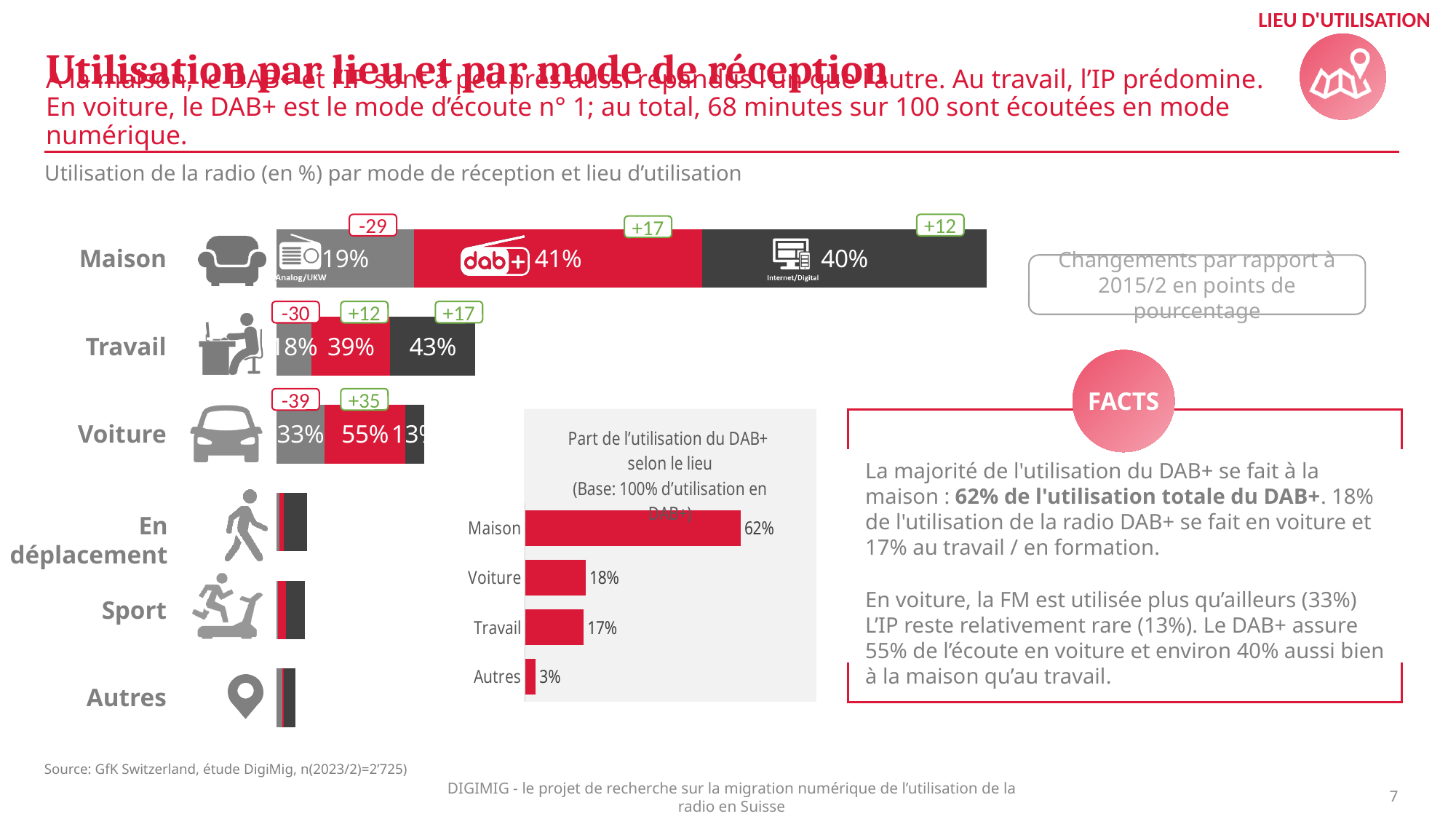
How many locations are shown in the chart 'Part de l'utilisation du DAB+ selon le lieu'? 4 What kind of chart is 'Part de l'utilisation du DAB+ selon le lieu'? Bar chart In the chart 'Part de l'utilisation du DAB+ selon le lieu', which location has the lowest share? Autres In the stacked bar chart on the left, what is the Internet/Digital share for Travail? 43% In the chart 'Part de l'utilisation du DAB+ selon le lieu', what is the difference between the values for Maison and Voiture? 44% In the chart 'Part de l'utilisation du DAB+ selon le lieu', which location has the highest share? Maison In the chart 'Part de l'utilisation du DAB+ selon le lieu', what is the value for Maison? 62% In the stacked bar chart on the left, which is larger for Travail: the DAB+ share or the Internet/Digital share? Internet/Digital In the stacked bar chart on the left, what is the DAB+ share for Maison? 41% In the stacked bar chart on the left, which reception mode has the largest share for Voiture? DAB+ In the stacked bar chart on the left, what is the change in percentage points since 2015/2 shown for DAB+ in Voiture? +35 In the stacked bar chart on the left, what is the Analog/UKW share for Voiture? 33%